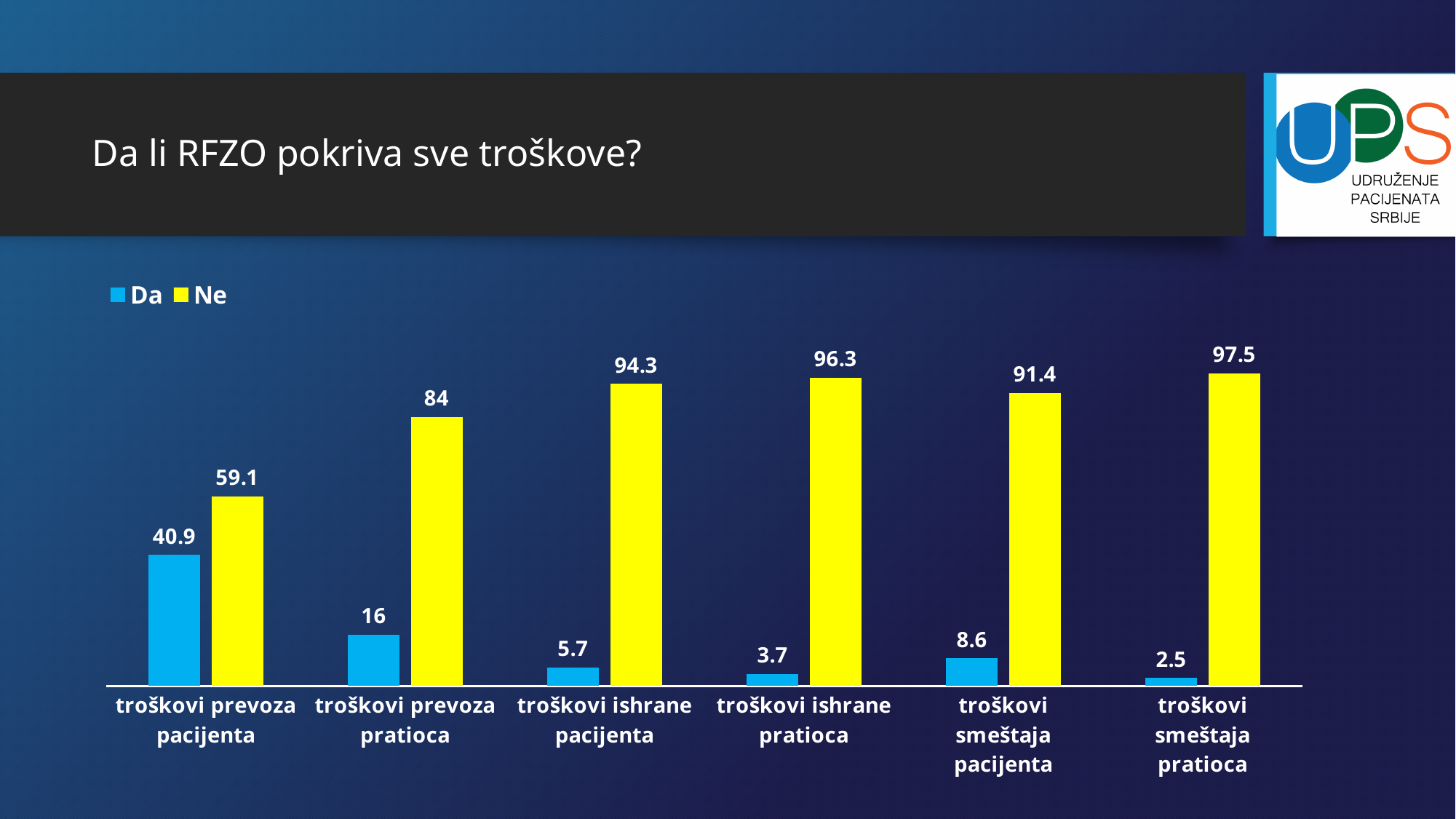
What is the "Ne" value for "troškovi smeštaja pratioca"? 97.5 What is the "Da" value for "troškovi prevoza pacijenta"? 40.9 What kind of chart is shown on the slide? bar chart What is the "Da" value for "troškovi ishrane pratioca"? 3.7 What is the title of the slide? Da li RFZO pokriva sve troškove? How many categories are shown on the x axis? 6 What colour are the "Ne" bars? yellow What is the difference between the "Ne" and "Da" values for "troškovi prevoza pratioca"? 68 Which category has the lowest "Da" value? troškovi smeštaja pratioca Which category has the highest "Ne" value? troškovi smeštaja pratioca Which is larger: the "Da" value for "troškovi prevoza pacijenta" or the "Da" value for "troškovi prevoza pratioca"? troškovi prevoza pacijenta How many series does the legend list? 2